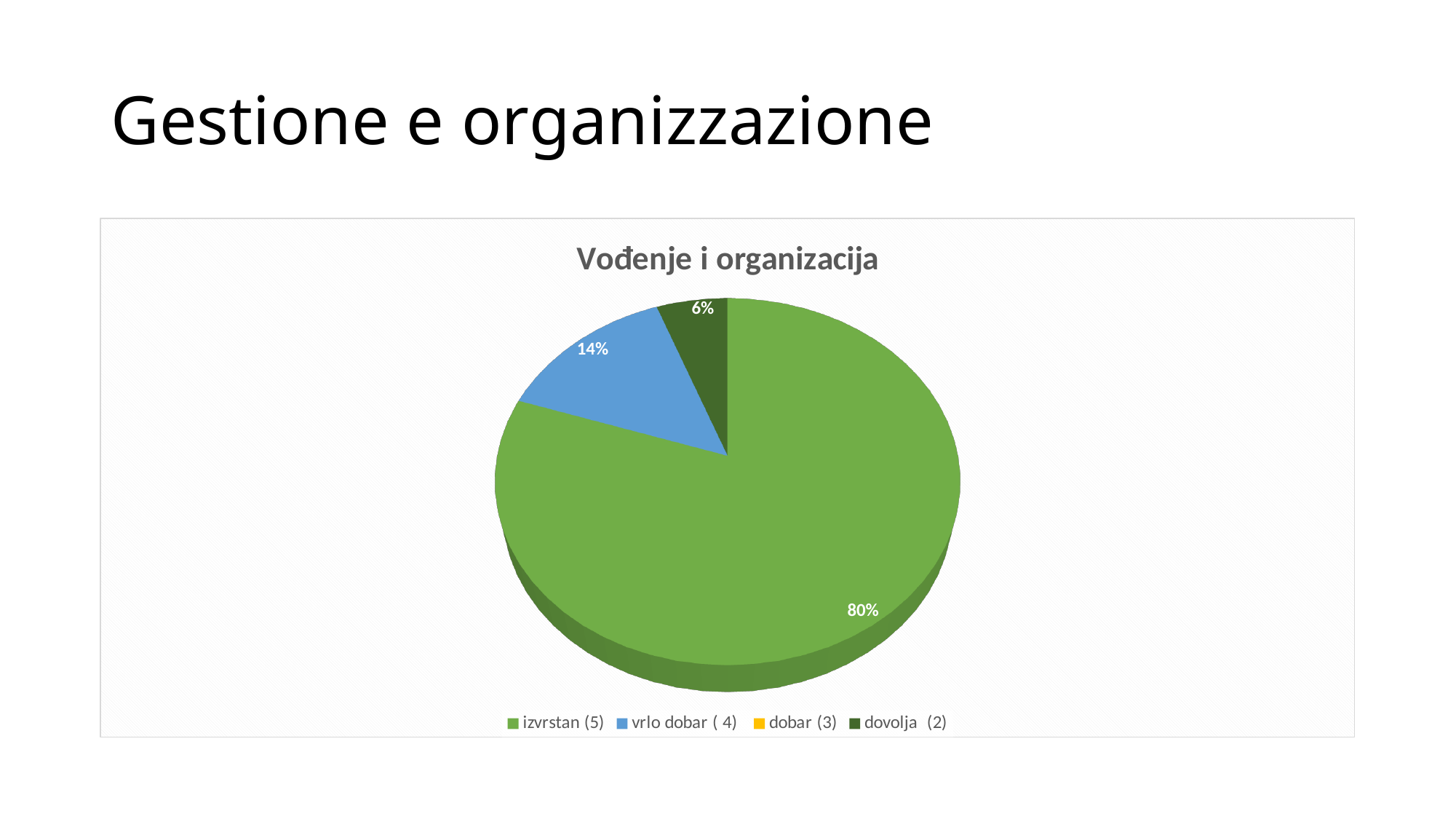
Which is larger, the slice for vrlo dobar ( 4) or the slice for dovolja (2)? vrlo dobar ( 4) What is the difference in percentage points between izvrstan (5) and vrlo dobar ( 4)? 66 What share of the pie does vrlo dobar ( 4) have? 14% Which category has the largest slice of the pie? izvrstan (5) What is the title of the chart? Vođenje i organizacija Which of the visible slices is the smallest? dovolja (2) How many entries does the legend list? 4 What kind of chart is shown on the slide? pie chart What share of the pie does izvrstan (5) have? 80% What colour is the slice for vrlo dobar ( 4)? blue What share of the pie does dovolja (2) have? 6% What is the combined share of vrlo dobar ( 4) and dovolja (2)? 20%